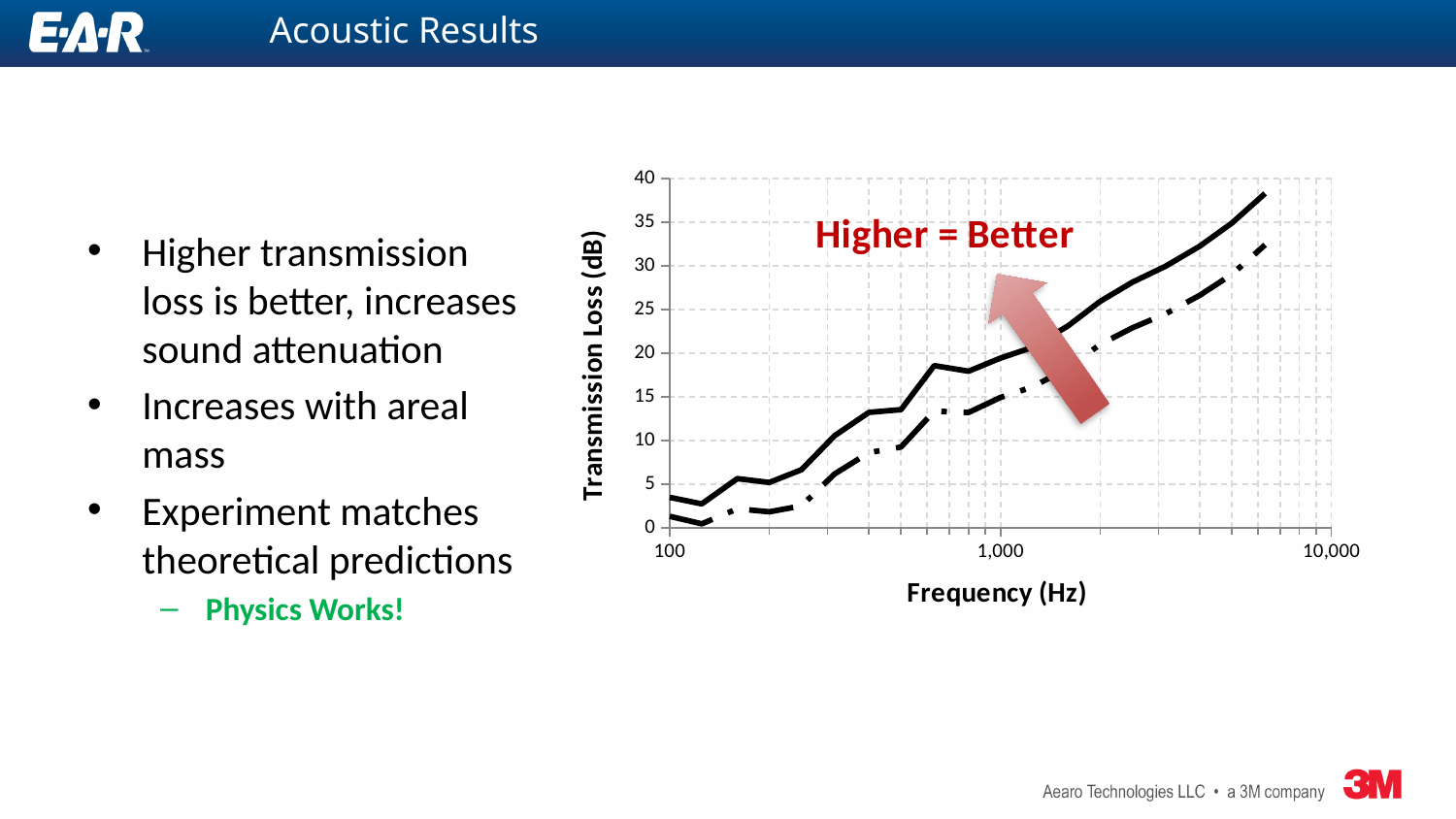
What is the maximum value shown on the vertical axis of the chart? 40 How many lines are plotted on the chart? 2 Do the plotted lines rise or fall as frequency increases along the x axis? rise Is the value of the solid line at 100 Hz greater or less than 5? less What is the title of the horizontal axis of the chart? Frequency (Hz) Which line is higher across the chart, the solid line or the dashed line? the solid line What kind of chart is shown on the slide? line chart Is the highest value reached by the solid line greater or less than 35? greater Is the value of the dashed line at 1,000 Hz greater or less than 10? greater What is the title of the vertical axis of the chart? Transmission Loss (dB)